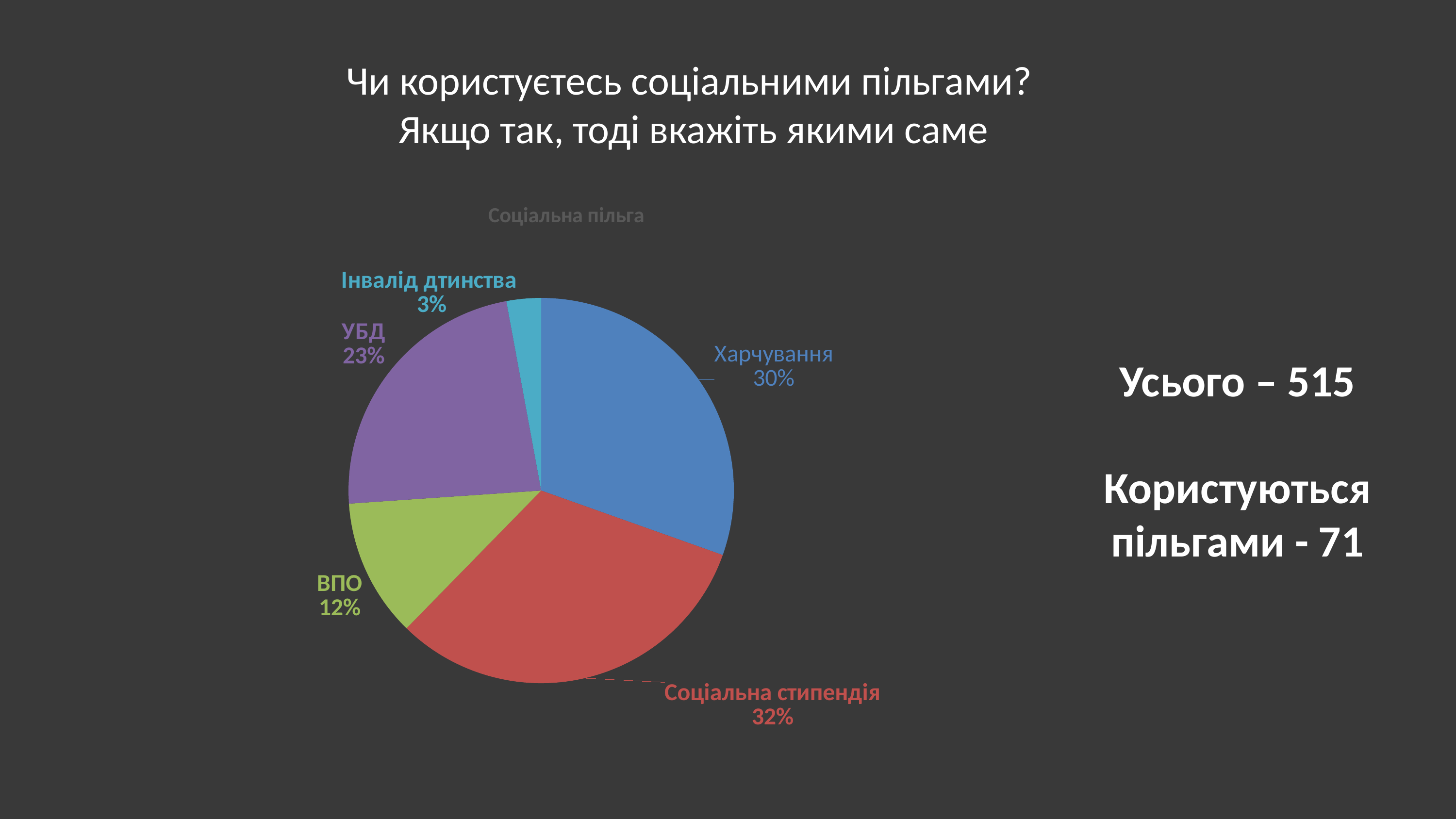
What share of the pie does Харчування have? 30% How many slices does the pie chart have? 5 Which is larger, the slice for Харчування or the slice for УБД? Харчування What share of the pie does ВПО have? 12% Which category has the smallest slice? Інвалід дтинства What is the difference in percentage points between УБД and ВПО? 11% What share of the pie does Соціальна стипендія have? 32% What is the chart's title? Соціальна пільга Which category has the largest slice? Соціальна стипендія What type of chart is shown on the slide? pie chart